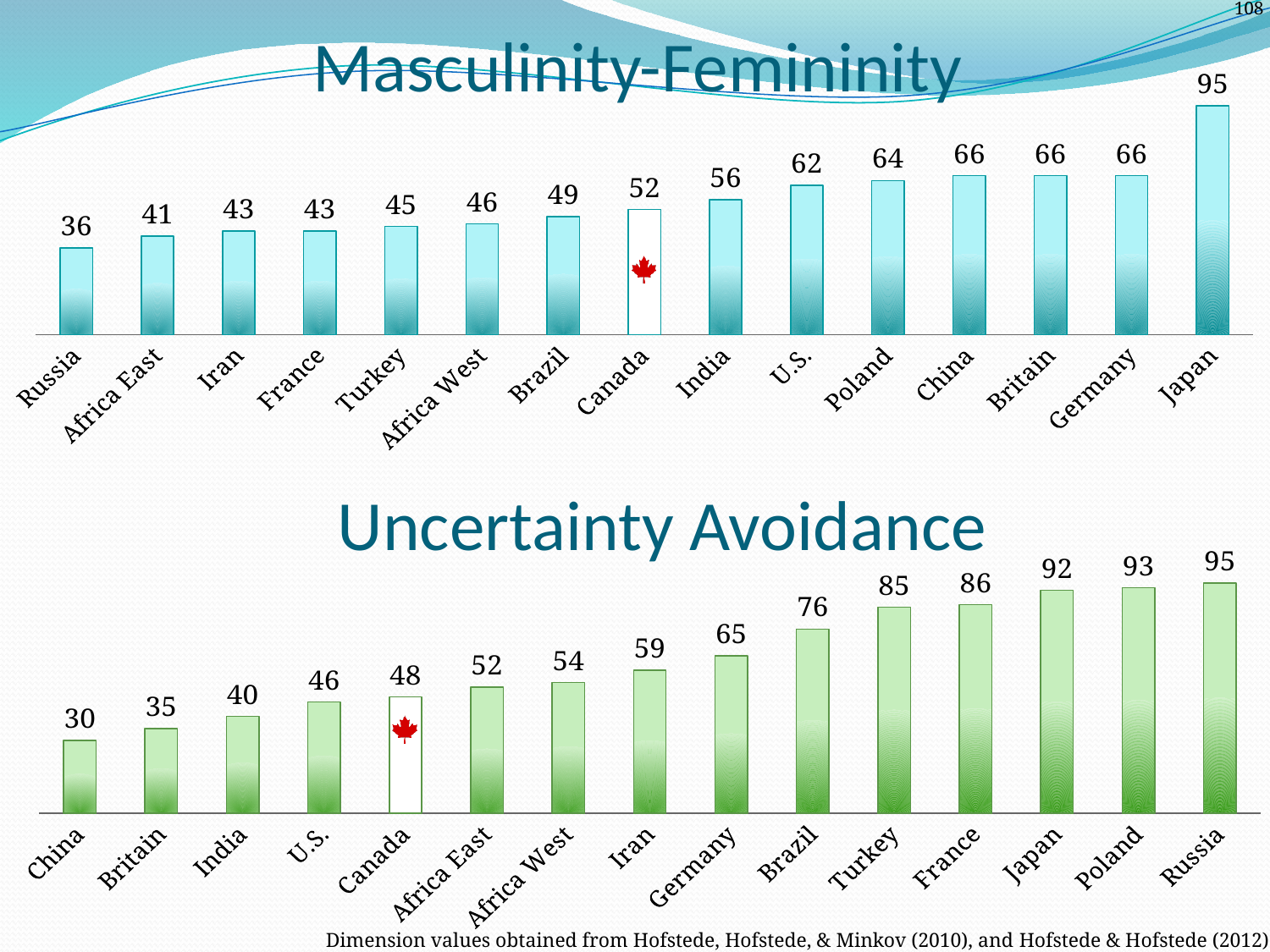
In the Uncertainty Avoidance chart, which country has the lowest value? China In the Masculinity-Femininity chart, which country has the lowest value? Russia In the Uncertainty Avoidance chart, what is the value for Brazil? 76 In the Masculinity-Femininity chart, what is the difference between Japan and Germany? 29 In the Masculinity-Femininity chart, how many countries are shown? 15 What type of chart is the Uncertainty Avoidance chart? bar chart In the Masculinity-Femininity chart, what is the value for Canada? 52 In the Uncertainty Avoidance chart, which is larger, the value for Turkey or the value for Germany? Turkey In the Uncertainty Avoidance chart, what is the difference between Canada and the U.S.? 2 In the Masculinity-Femininity chart, which country has the highest value? Japan In the Uncertainty Avoidance chart, do the values rise or fall from left to right? rise In the Uncertainty Avoidance chart, which country has the highest value? Russia